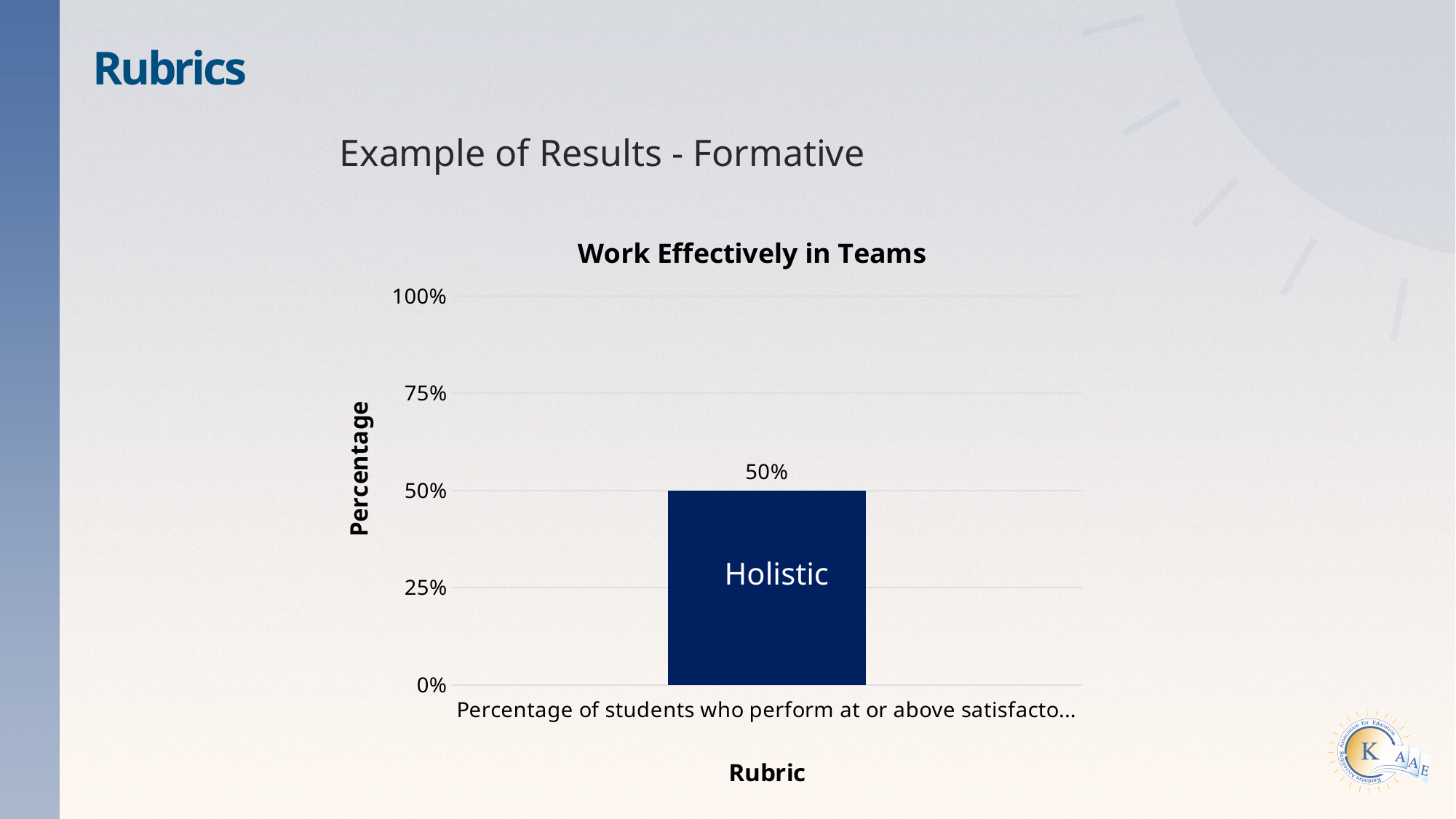
Is the value for Holistic greater or less than 25%? greater What is the label on the vertical axis of the chart? Percentage What kind of chart is shown on the slide? bar chart Is the value for Holistic greater or less than 75%? less What is the highest value shown on the vertical axis of the chart? 100% What is the title of the chart? Work Effectively in Teams What is the value of the Holistic bar in the Work Effectively in Teams chart? 50% How many bars are plotted in the Work Effectively in Teams chart? 1 What label is printed inside the bar in the chart? Holistic